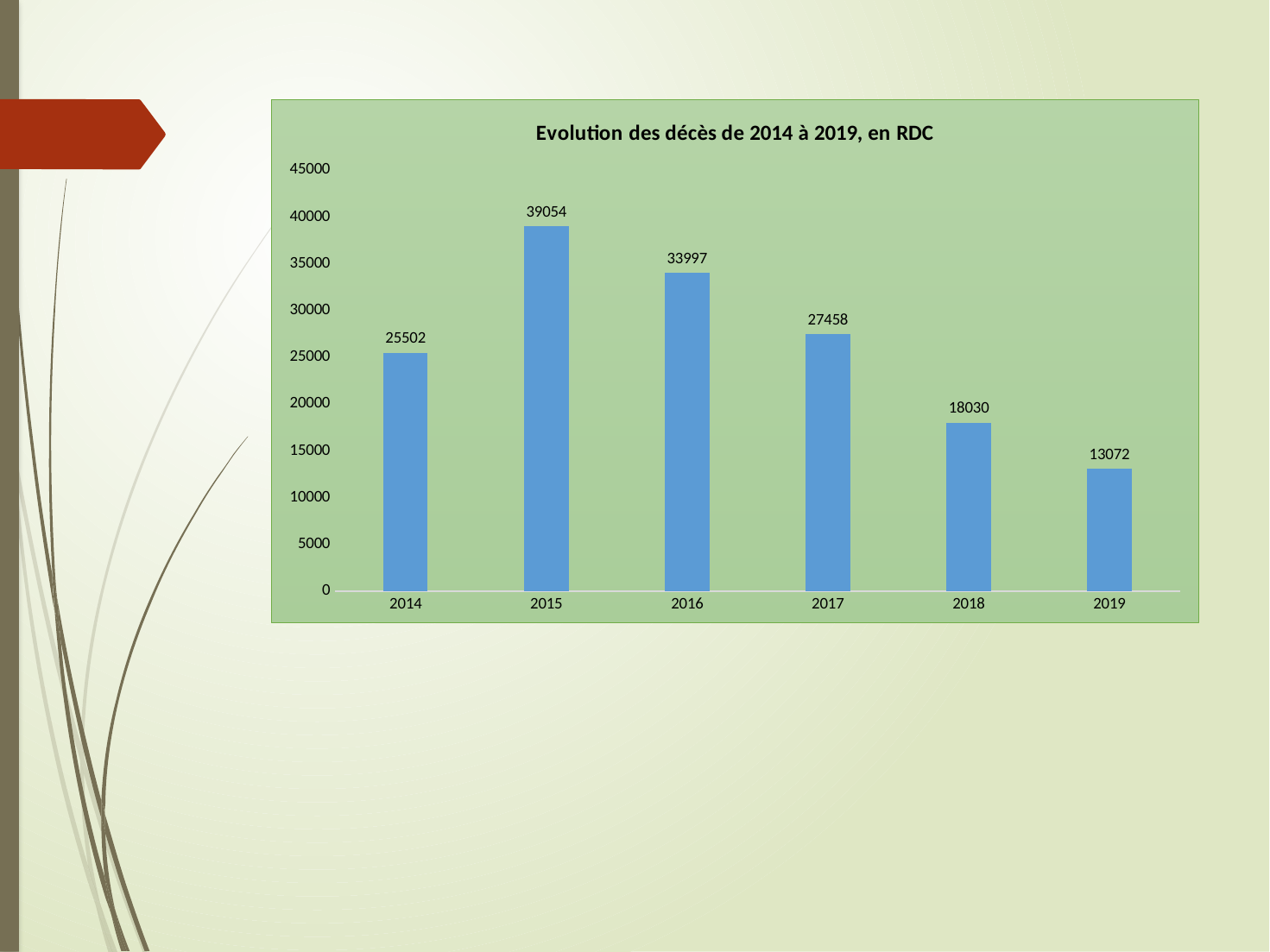
How many years are shown on the x axis? 6 What is the difference between the values for 2018 and 2019? 4958 Which year has the lowest value? 2019 Which is larger, the value for 2014 or the value for 2017? 2017 What is the value for 2015? 39054 What is the title of the chart? Evolution des décès de 2014 à 2019, en RDC What is the value for 2017? 27458 What is the value for 2019? 13072 Is the value for 2016 greater or less than 30000? greater What is the difference between the values for 2015 and 2016? 5057 Which year has the highest value? 2015 What kind of chart is this? bar chart